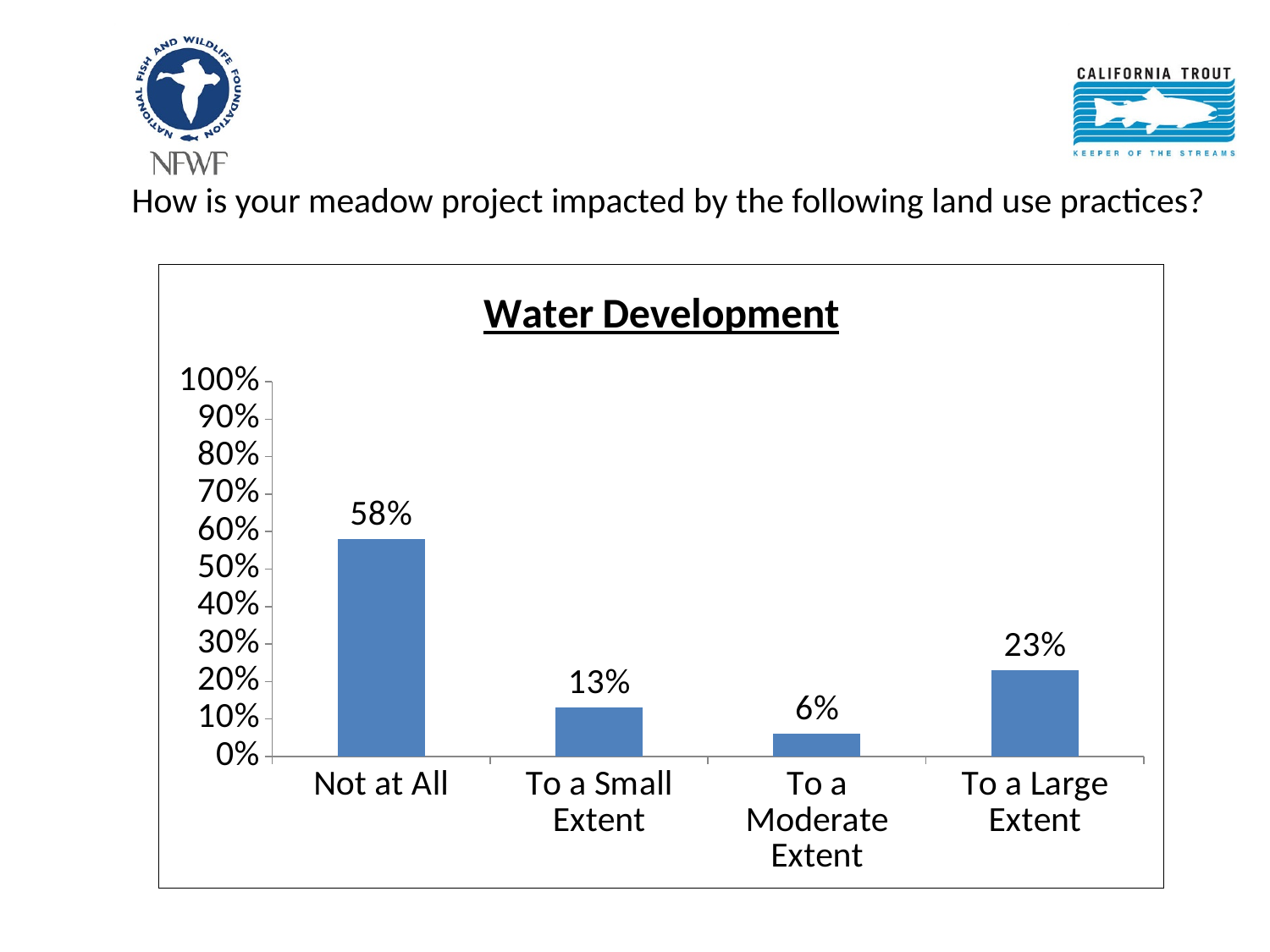
What is the difference between the values for "Not at All" and "To a Large Extent"? 35% What is the value for "To a Small Extent"? 13% Is the value for "Not at All" greater or less than 50%? greater What is the title of the chart? Water Development Which category has the lowest value? To a Moderate Extent What is the value for "Not at All"? 58% What kind of chart is shown? bar chart What is the value for "To a Moderate Extent"? 6% Which category has the highest value? Not at All Which is larger, the value for "To a Small Extent" or "To a Large Extent"? To a Large Extent What is the value for "To a Large Extent"? 23% How many categories are shown on the x axis? 4